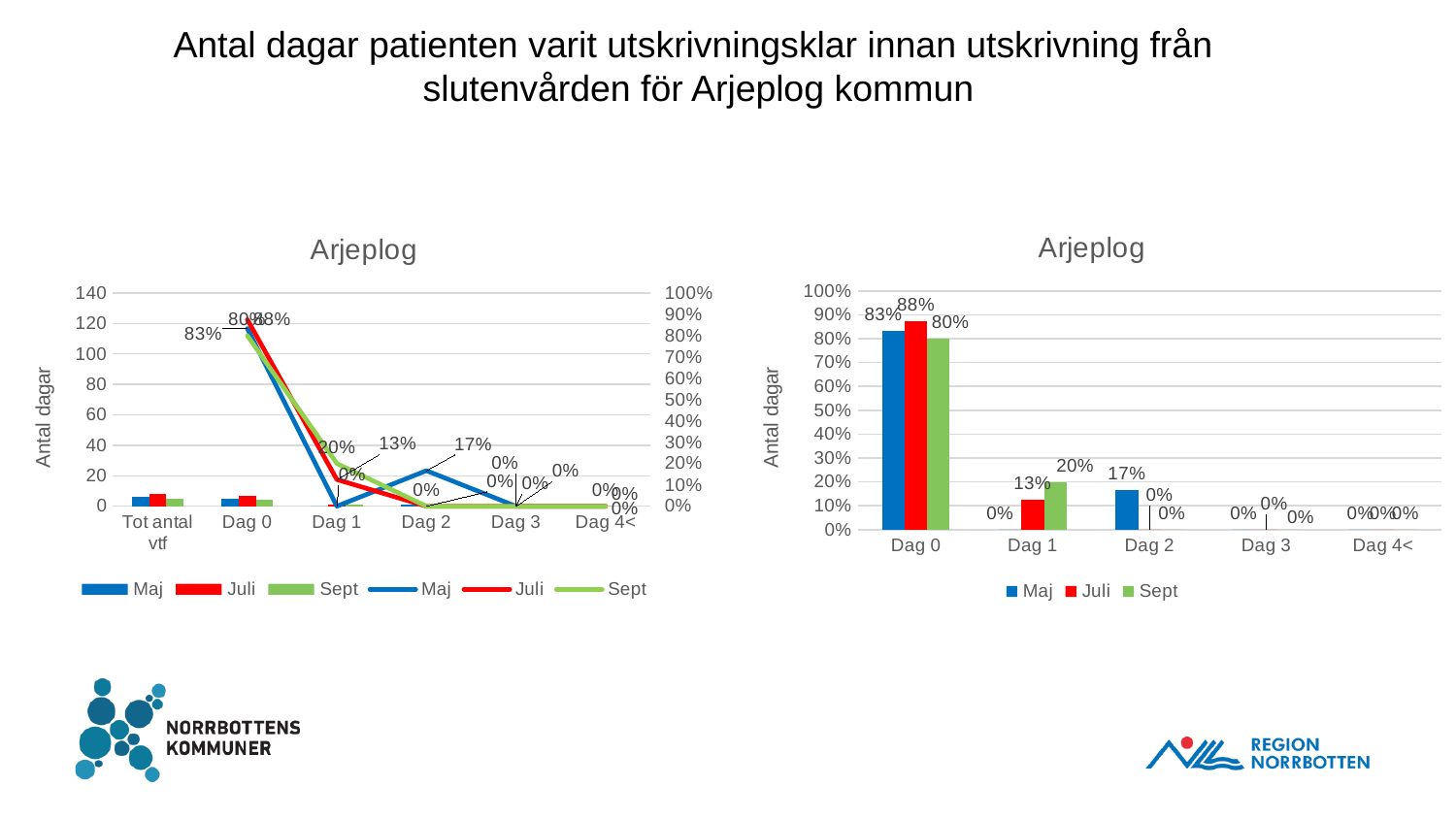
What kind of chart is the right-hand chart? Bar chart In the right-hand chart, what is the difference between Juli and Sept at Dag 0? 8% In the left-hand chart, what is the value of the Maj line at Dag 0? 83% In the right-hand chart, what is the value for Maj at Dag 2? 17% In the right-hand chart, how many series does the legend list? 3 In the right-hand chart, which month has the lowest value at Dag 0? Sept In the right-hand chart, which month has the highest value at Dag 0? Juli In the left-hand chart, how many categories are shown on the x axis? 6 In the right-hand chart, what is the value for Sept at Dag 1? 20% In the right-hand chart, which is larger at Dag 1: Juli or Sept? Sept In the right-hand chart, how many categories are shown on the x axis? 5 In the right-hand chart, what is the value for Juli at Dag 0? 88%